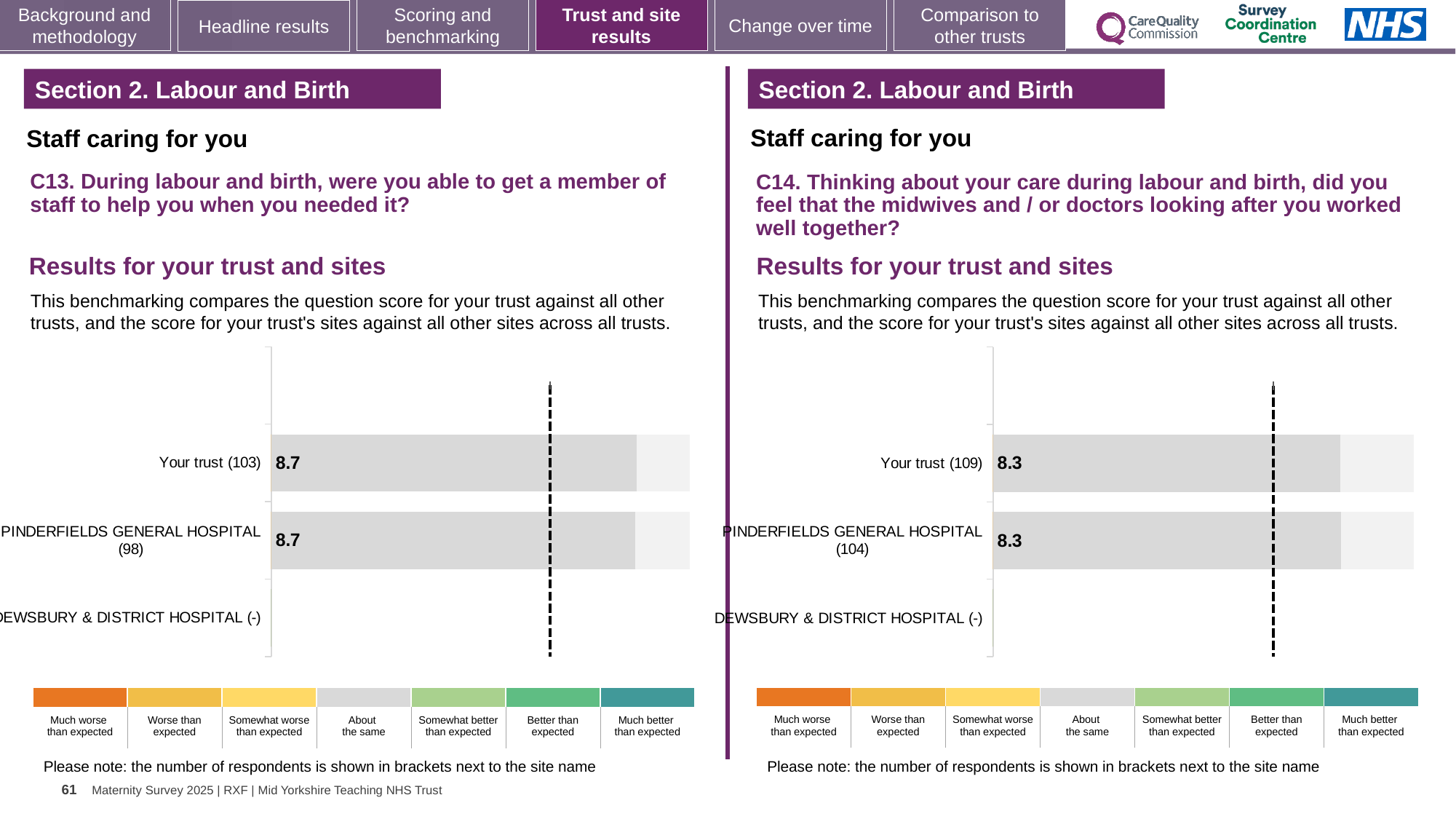
On the left chart (C13), how many respondents are shown in brackets for Your trust? 103 On the right chart (C14), what is the score for Pinderfields General Hospital? 8.3 On the right chart (C14), what is the difference between the score for Your trust and the score for Pinderfields General Hospital? 0 How many categories (sites) are listed on the right chart (C14)? 3 What kind of chart is used on the left (C13)? Bar chart How many categories (sites) are listed on the left chart (C13)? 3 On the left chart (C13), what is the score for Your trust? 8.7 On the left chart (C13), what is the score for Pinderfields General Hospital? 8.7 On the right chart (C14), what is the score for Your trust? 8.3 On the right chart (C14), how many respondents are shown in brackets for Pinderfields General Hospital? 104 On the left chart (C13), what is the difference between the score for Your trust and the score for Pinderfields General Hospital? 0 Which is larger: the Your trust score on the left chart (C13) or the Your trust score on the right chart (C14)? Left chart (C13)